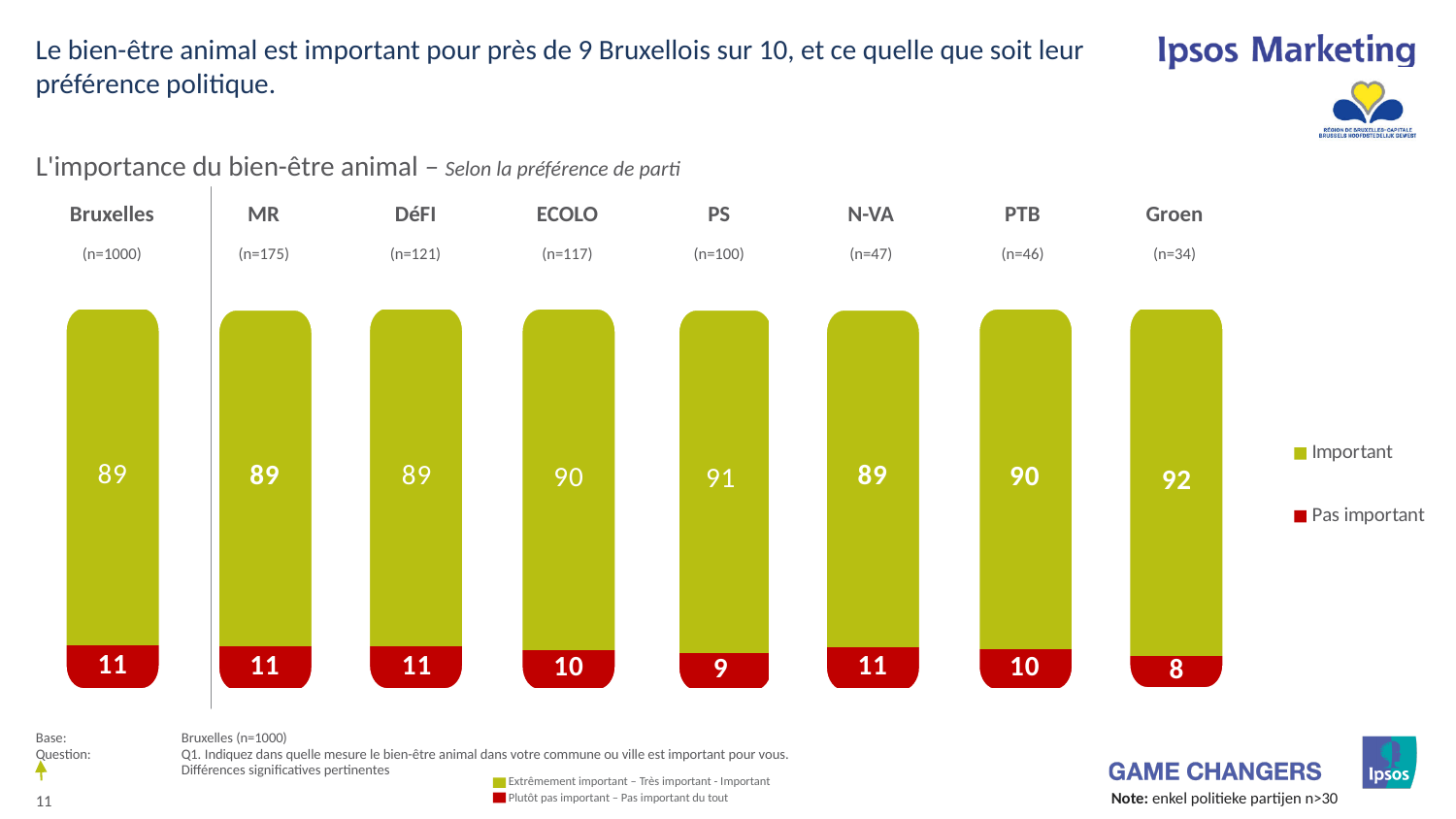
What is the difference between the 'Important' values for Groen and Bruxelles? 3 Which category has the highest 'Important' value? Groen What is the 'Important' value for Bruxelles? 89 How many categories are shown on the x axis? 8 What is the 'Important' value for Groen? 92 What kind of chart is shown? Stacked bar chart What is the 'Pas important' value for PS? 9 What are the two legend entries? Important, Pas important Which category has the lowest 'Pas important' value? Groen Which is larger, the 'Pas important' value for MR or for PS? MR What is the total of the stacked bar for ECOLO? 100 How many series does the legend list? 2